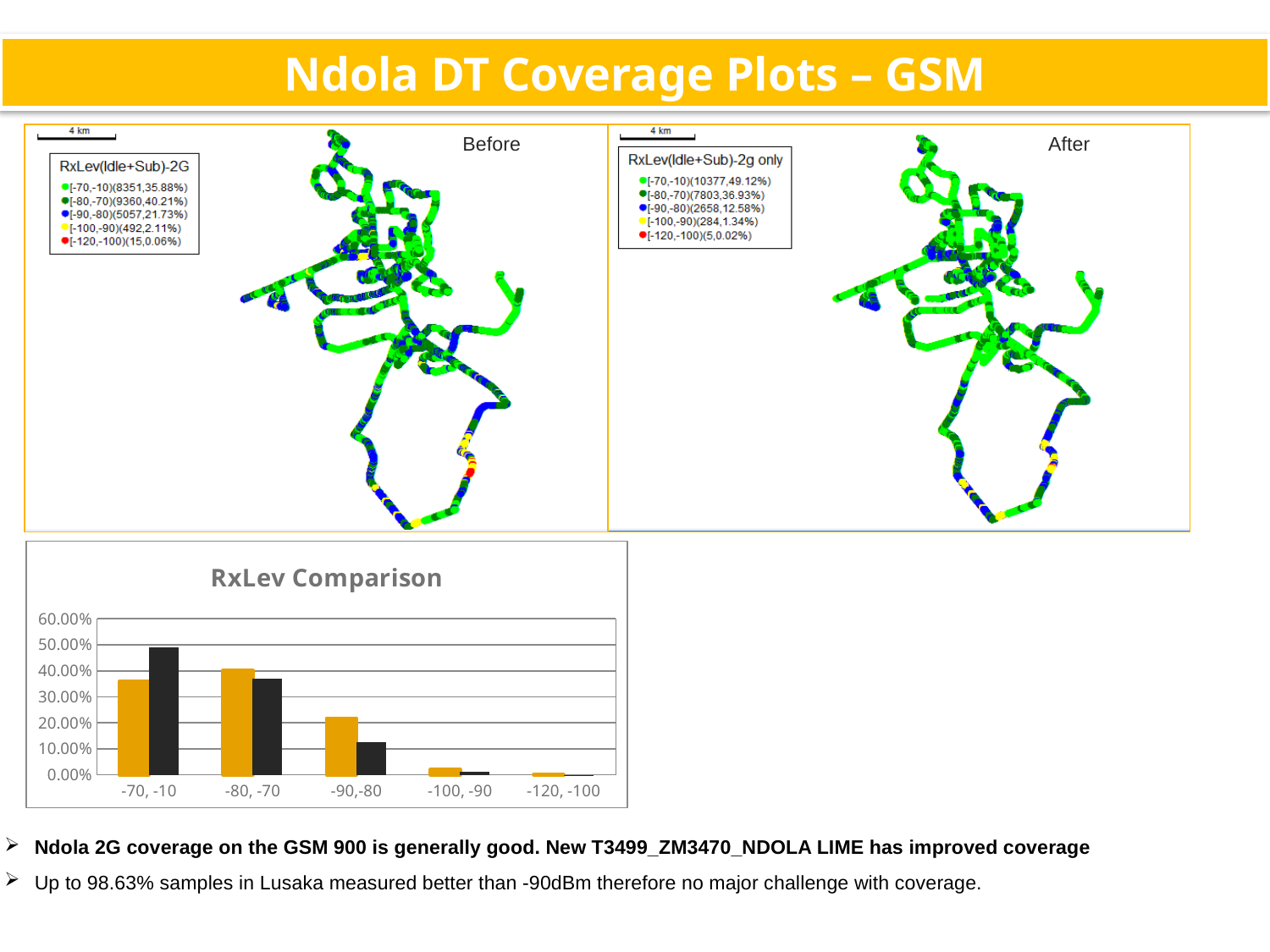
What is the highest tick value shown on the y axis of the RxLev Comparison chart? 60.00% In the RxLev Comparison chart, is the orange bar for -100, -90 greater or less than 10.00%? less In the RxLev Comparison chart, is the black bar for -70, -10 greater or less than 40.00%? greater What is the title of the bar chart at the bottom of the slide? RxLev Comparison How many categories are shown on the x axis of the RxLev Comparison chart? 5 In the RxLev Comparison chart, which category has the lowest values for both bars? -120, -100 In the RxLev Comparison chart, do the black bars rise or fall moving from -70, -10 to -120, -100 along the x axis? fall In the RxLev Comparison chart, is the black bar for -90, -80 greater or less than 20.00%? less What kind of chart is the RxLev Comparison chart? bar chart In the RxLev Comparison chart, for the -70, -10 category, which bar is taller, the orange one or the black one? the black one In the RxLev Comparison chart, which category has the tallest black bar? -70, -10 In the RxLev Comparison chart, which category has the tallest orange bar? -80, -70